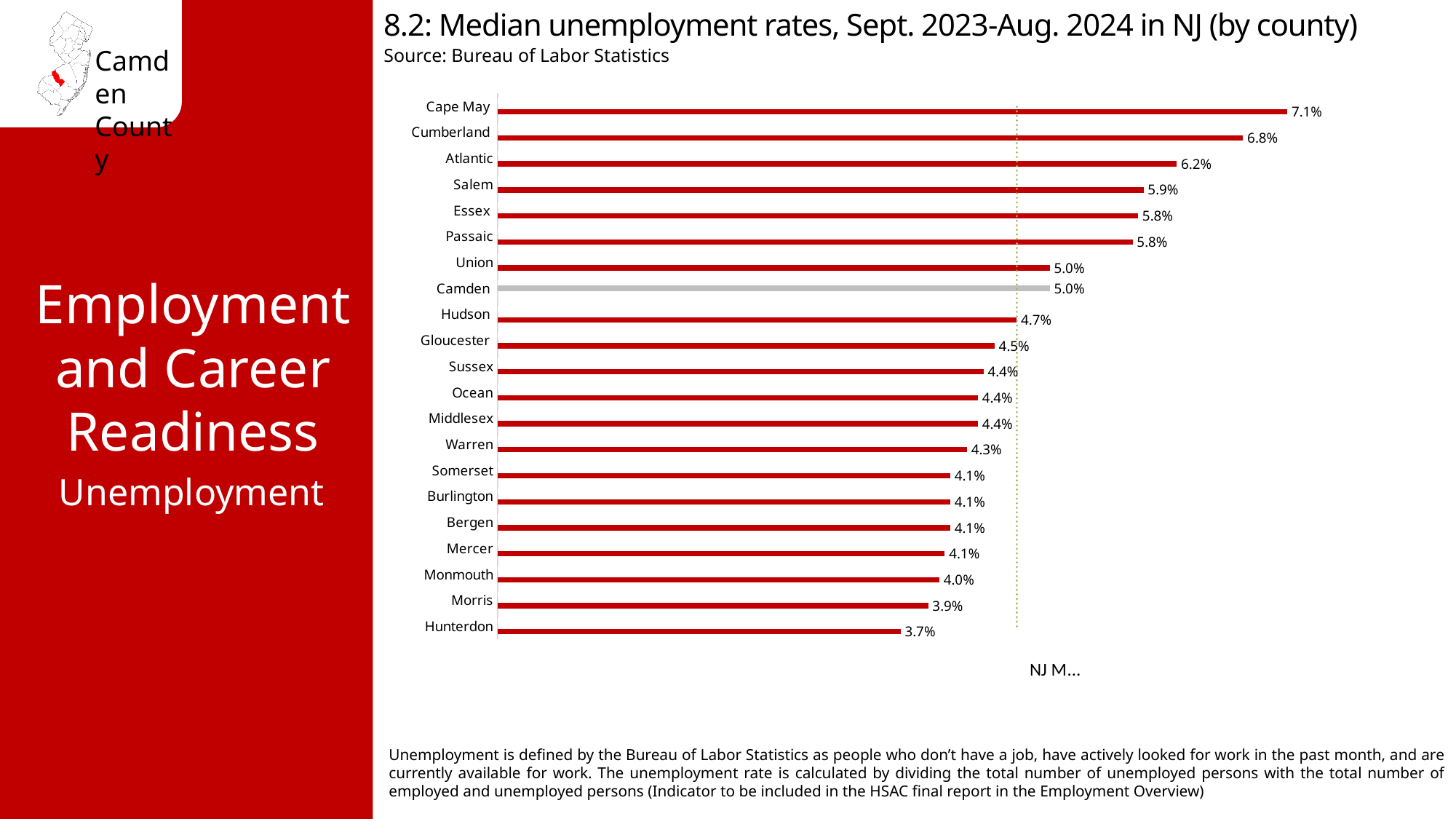
What is the difference between the median unemployment rates of Cumberland and Camden? 1.8% What is the median unemployment rate for Gloucester? 4.5% What is the median unemployment rate for Camden County? 5.0% What is the median unemployment rate for Cape May? 7.1% How many counties are shown in the chart? 21 What type of chart is used to show the median unemployment rates? Bar chart Which county has a higher median unemployment rate, Atlantic or Salem? Atlantic What is the median unemployment rate for Hunterdon? 3.7% Which county's bar is shown in gray rather than red? Camden What is the difference between the median unemployment rates of Cape May and Hunterdon? 3.4% Which county has the highest median unemployment rate? Cape May Which county has the lowest median unemployment rate? Hunterdon